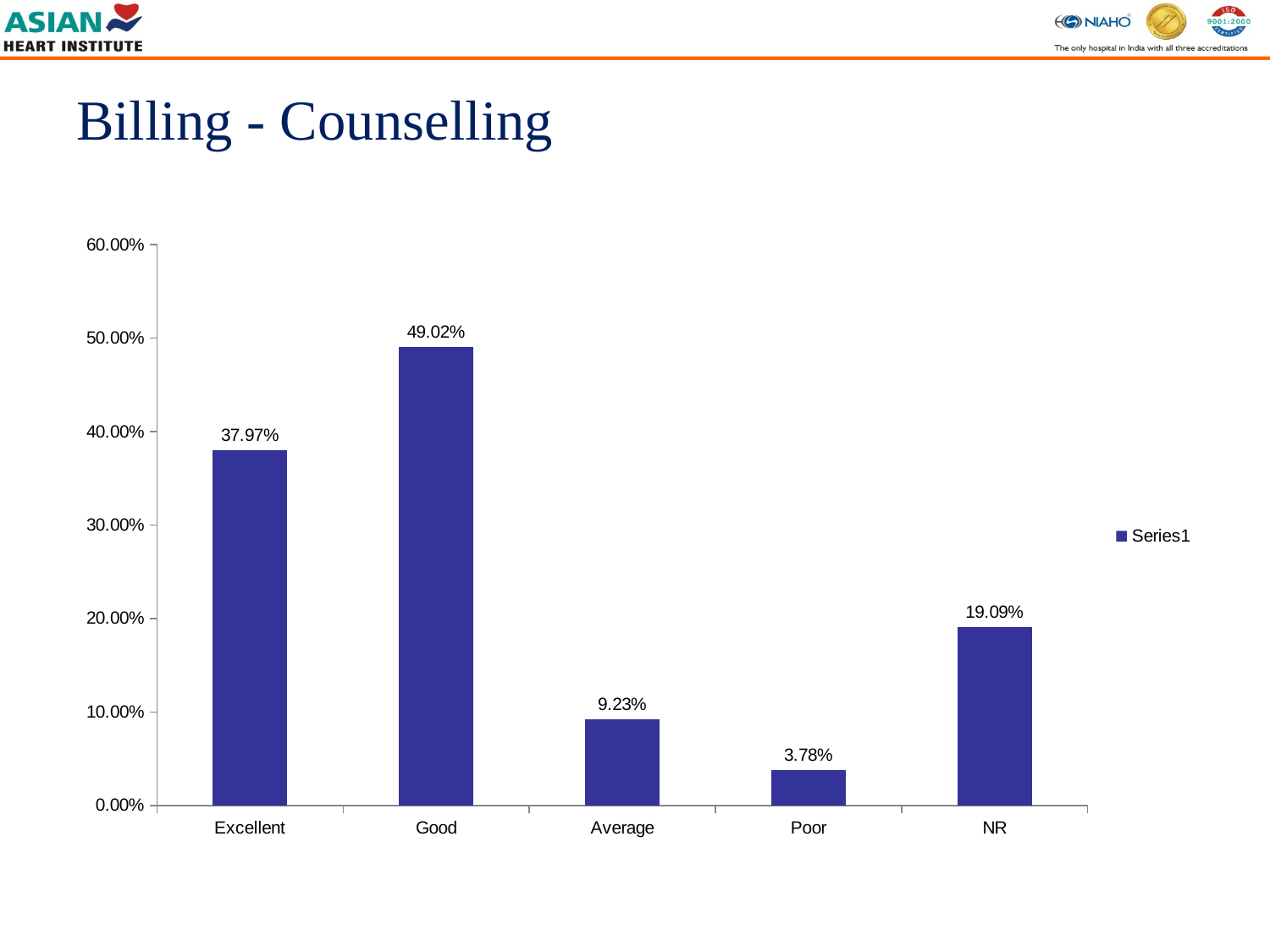
What is the value for NR? 19.09% Which category has the highest value? Good What is the value for Excellent? 37.97% What is the title of the slide containing the chart? Billing - Counselling What is the value for Poor? 3.78% How many categories are shown on the x axis? 5 Is the value for Average greater or less than 10.00%? less What kind of chart is shown on the slide? bar chart Which is larger, the value for Average or the value for NR? NR Which category has the lowest value? Poor What is the value for Good? 49.02% What is the difference between the values for Good and Excellent? 11.05%